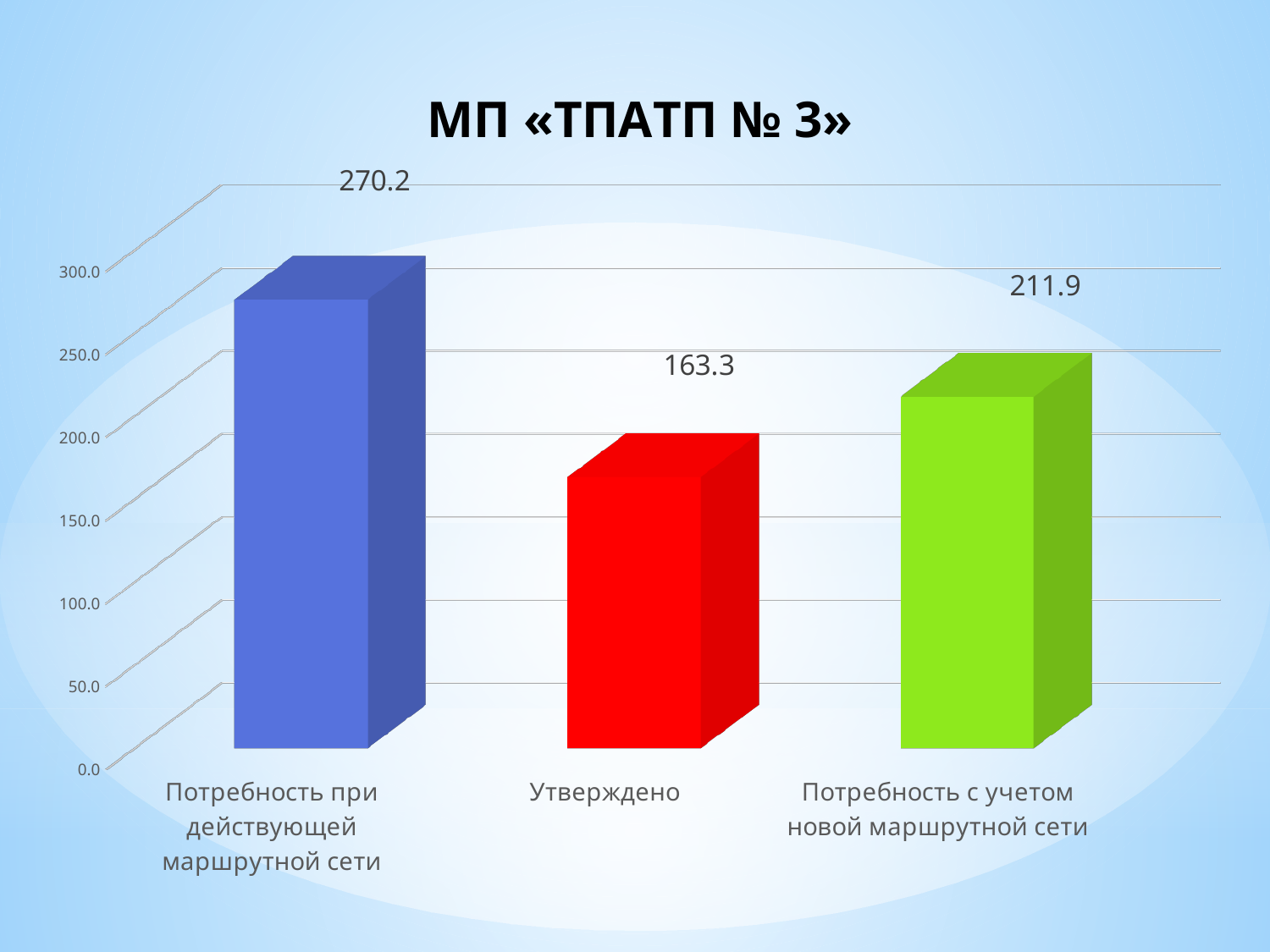
What is the value for «Утверждено»? 163.3 Which category has the lowest value? Утверждено Is the value for «Утверждено» greater or less than 200.0? less Which category has the highest value? Потребность при действующей маршрутной сети Which is larger: the value for «Утверждено» or for «Потребность с учетом новой маршрутной сети»? Потребность с учетом новой маршрутной сети What is the title of the chart? МП «ТПАТП № 3» What is the value for «Потребность при действующей маршрутной сети»? 270.2 What is the difference between the values for «Потребность при действующей маршрутной сети» and «Утверждено»? 106.9 What is the difference between the values for «Потребность с учетом новой маршрутной сети» and «Утверждено»? 48.6 What is the value for «Потребность с учетом новой маршрутной сети»? 211.9 What kind of chart is shown on the slide? bar chart How many categories are shown in the chart? 3